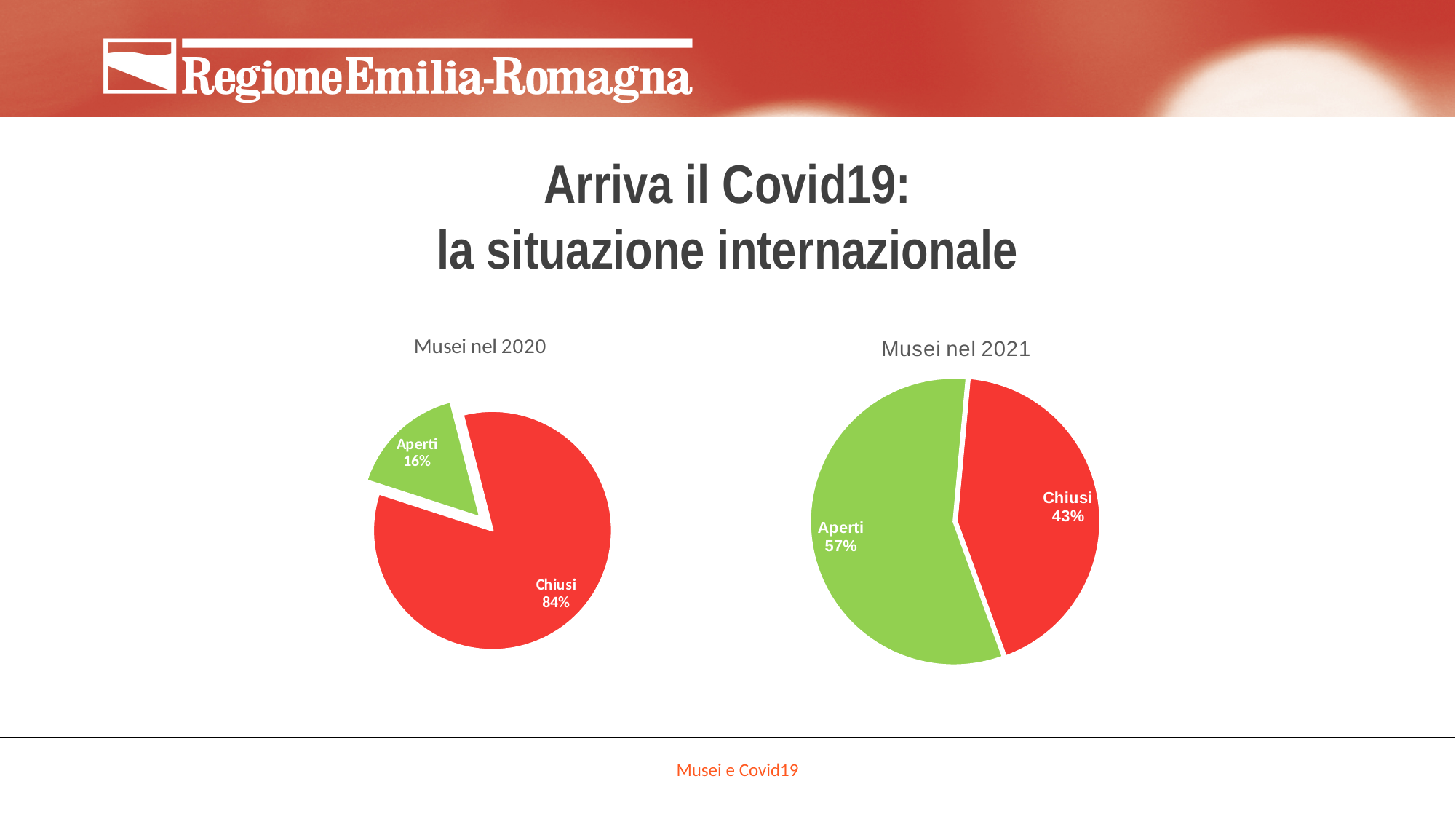
In the 'Musei nel 2020' chart, which slice is the largest? Chiusi In the 'Musei nel 2020' chart, what share of museums were Chiusi? 84% In the 'Musei nel 2021' chart, what is the difference between the Aperti and Chiusi shares? 14% In the 'Musei nel 2020' chart, what share of museums were Aperti? 16% In the 'Musei nel 2021' chart, which slice is the smallest? Chiusi In the 'Musei nel 2021' chart, what share of museums were Aperti? 57% What colour is the Aperti slice in the 'Musei nel 2021' chart? Green In the 'Musei nel 2020' chart, what is the difference between the Chiusi and Aperti shares? 68% Is the Aperti share larger in the 'Musei nel 2020' chart or in the 'Musei nel 2021' chart? Musei nel 2021 How many slices does the 'Musei nel 2021' chart have? 2 In the 'Musei nel 2021' chart, what share of museums were Chiusi? 43% What kind of chart is 'Musei nel 2020'? Pie chart